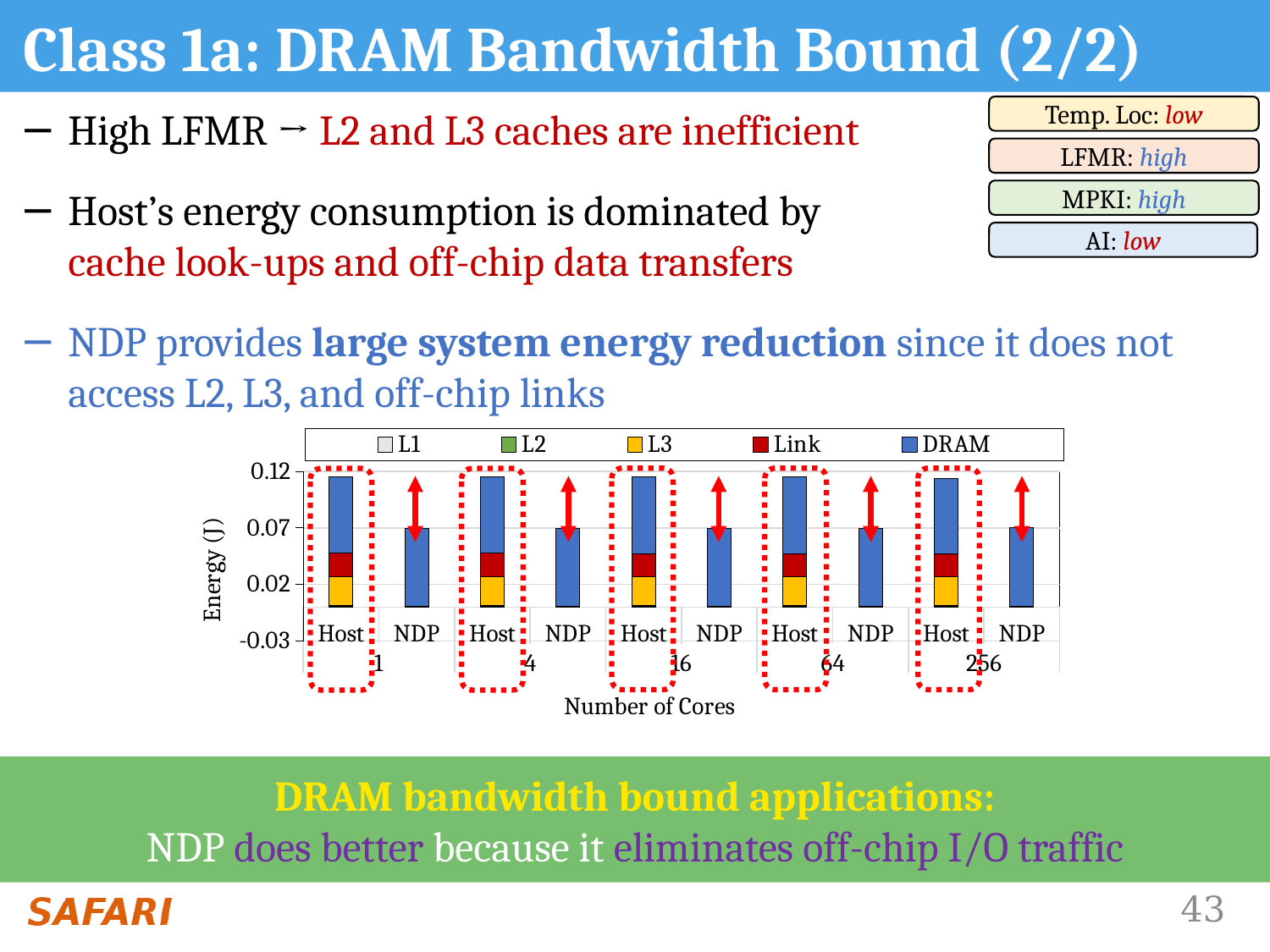
Do the Host bars rise, fall, or stay roughly constant as the number of cores increases from 1 to 256? stay roughly constant How many bars are plotted in the chart in total? 10 How many different numbers of cores are shown on the x axis of the chart? 5 Is the total energy of the Host bar at 256 cores greater or less than 0.02? greater Is the total energy of the Host bar at 16 cores greater or less than 0.07? greater Is the total energy of the NDP bar at 64 cores greater or less than 0.12? less What kind of chart is shown on the slide? bar chart What are the series listed in the chart's legend? L1, L2, L3, Link, DRAM Which single series makes up the NDP bars in the chart? DRAM How many series does the chart's legend list? 5 At 1 core, which bar is taller, Host or NDP? Host At 4 cores, which has the higher total energy, Host or NDP? Host